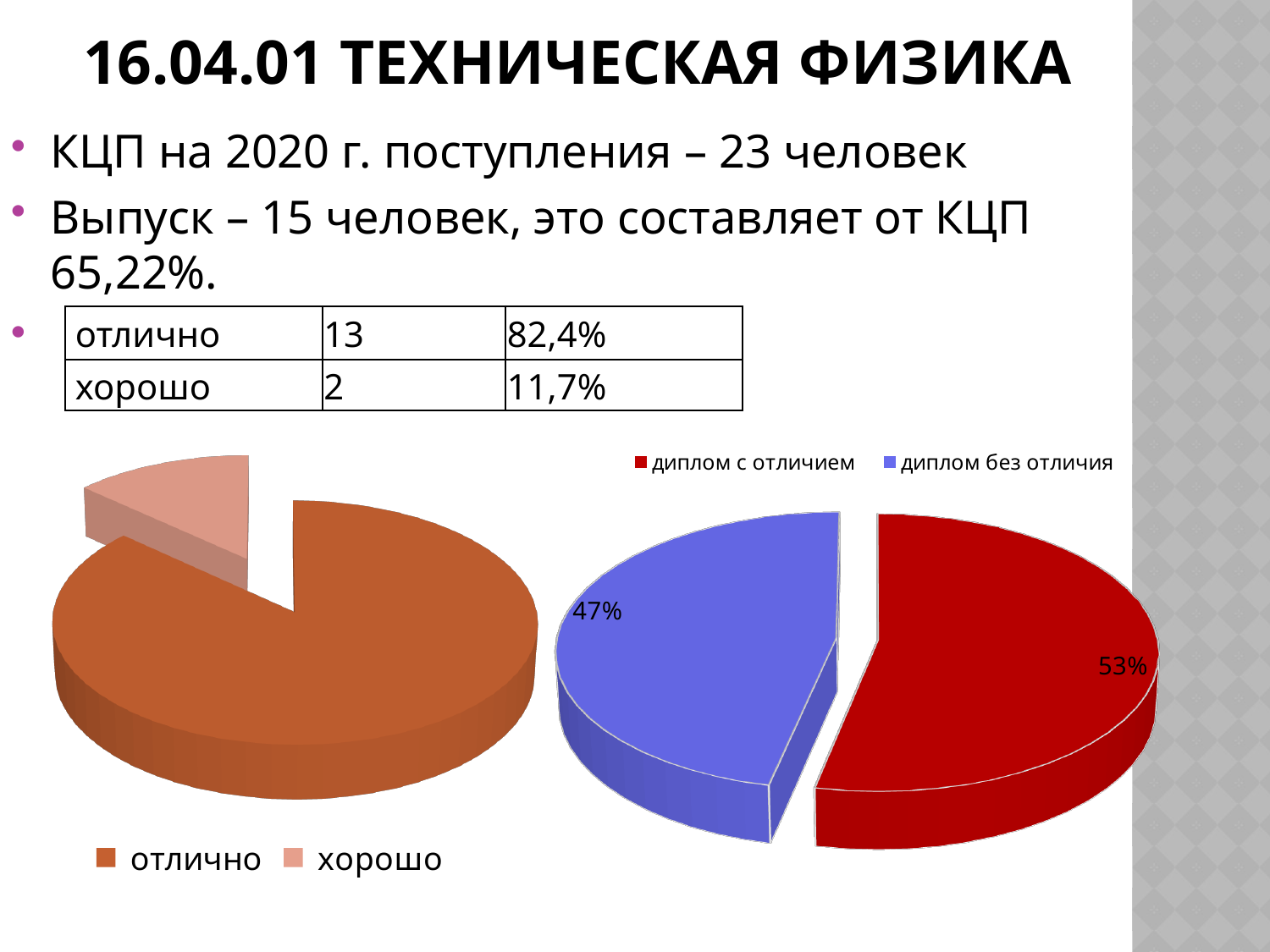
In the right pie chart, which colour is used for диплом без отличия? blue In the right pie chart, what share is shown for диплом без отличия? 47% In the left pie chart, how many slices are there? 2 In the right pie chart, which category has the larger slice? диплом с отличием In the left pie chart, which category has the smallest slice? хорошо In the right pie chart, what is the difference in percentage points between диплом с отличием and диплом без отличия? 6 percentage points What kind of chart is the chart on the left of the slide (отлично / хорошо)? pie chart In the left pie chart, what are the two legend entries? отлично, хорошо In the left pie chart, which category has the largest slice? отлично In the right pie chart, how many slices are there? 2 What kind of chart is the chart on the right of the slide (диплом с отличием / диплом без отличия)? pie chart In the right pie chart, what share is shown for диплом с отличием? 53%